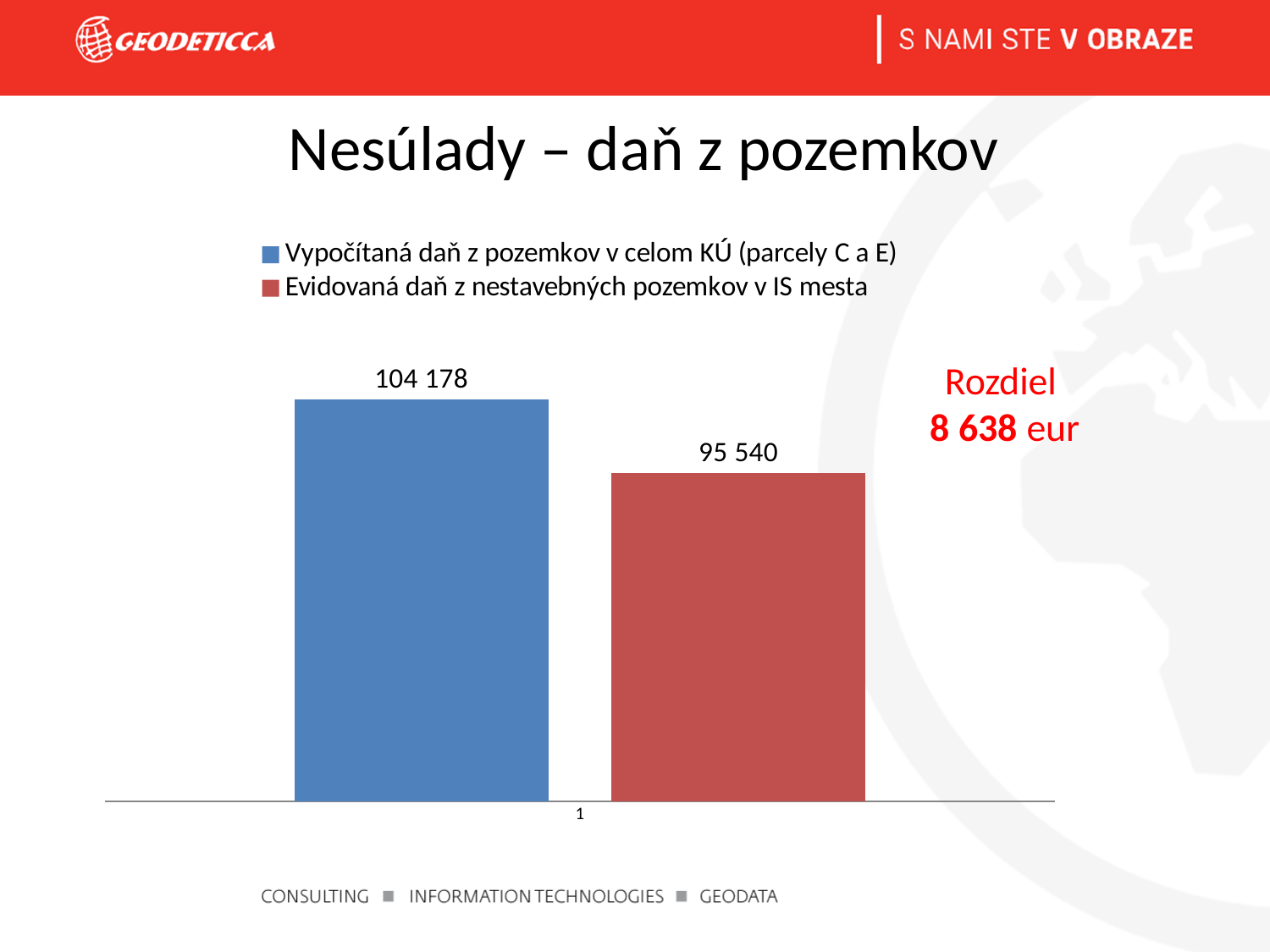
What kind of chart is shown on the slide? bar chart What is the difference between the two bars? 8 638 How many bars are plotted in the chart? 2 What difference ('Rozdiel') in eur is stated next to the chart? 8 638 eur What colour is the bar for 'Evidovaná daň z nestavebných pozemkov v IS mesta'? red What is the value for 'Evidovaná daň z nestavebných pozemkov v IS mesta'? 95 540 Which series has the lower value? Evidovaná daň z nestavebných pozemkov v IS mesta What is the value for 'Vypočítaná daň z pozemkov v celom KÚ (parcely C a E)'? 104 178 Which series has the higher value? Vypočítaná daň z pozemkov v celom KÚ (parcely C a E) How many series does the legend list? 2 What is the title of the slide? Nesúlady – daň z pozemkov Is the value for 'Vypočítaná daň z pozemkov v celom KÚ (parcely C a E)' larger or smaller than the value for 'Evidovaná daň z nestavebných pozemkov v IS mesta'? larger